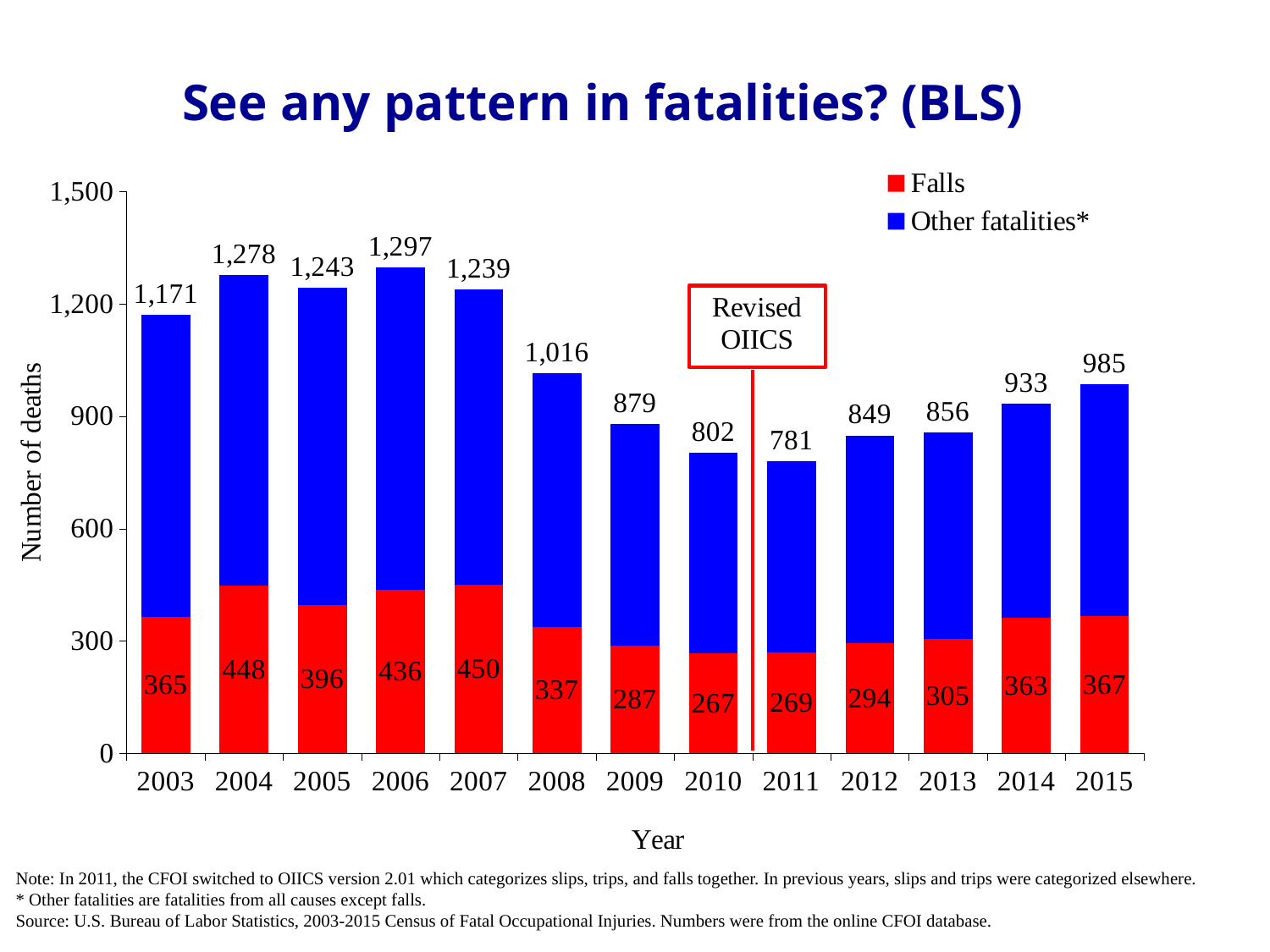
Is the total number of deaths in 2008 greater or less than 900? greater What is the difference between the total deaths in 2006 and 2011? 516 What is the total number of deaths shown for 2011? 781 What is the number of fall fatalities in 2007? 450 Which year has more fall fatalities, 2004 or 2014? 2004 What colour represents the Falls series? Red Which year has the lowest number of fall fatalities? 2010 How many series does the legend list? 2 Which year has the highest total number of deaths? 2006 How many years are shown on the x axis? 13 Do total deaths rise or fall from 2011 to 2015? Rise What type of chart is shown on the slide? Stacked bar chart